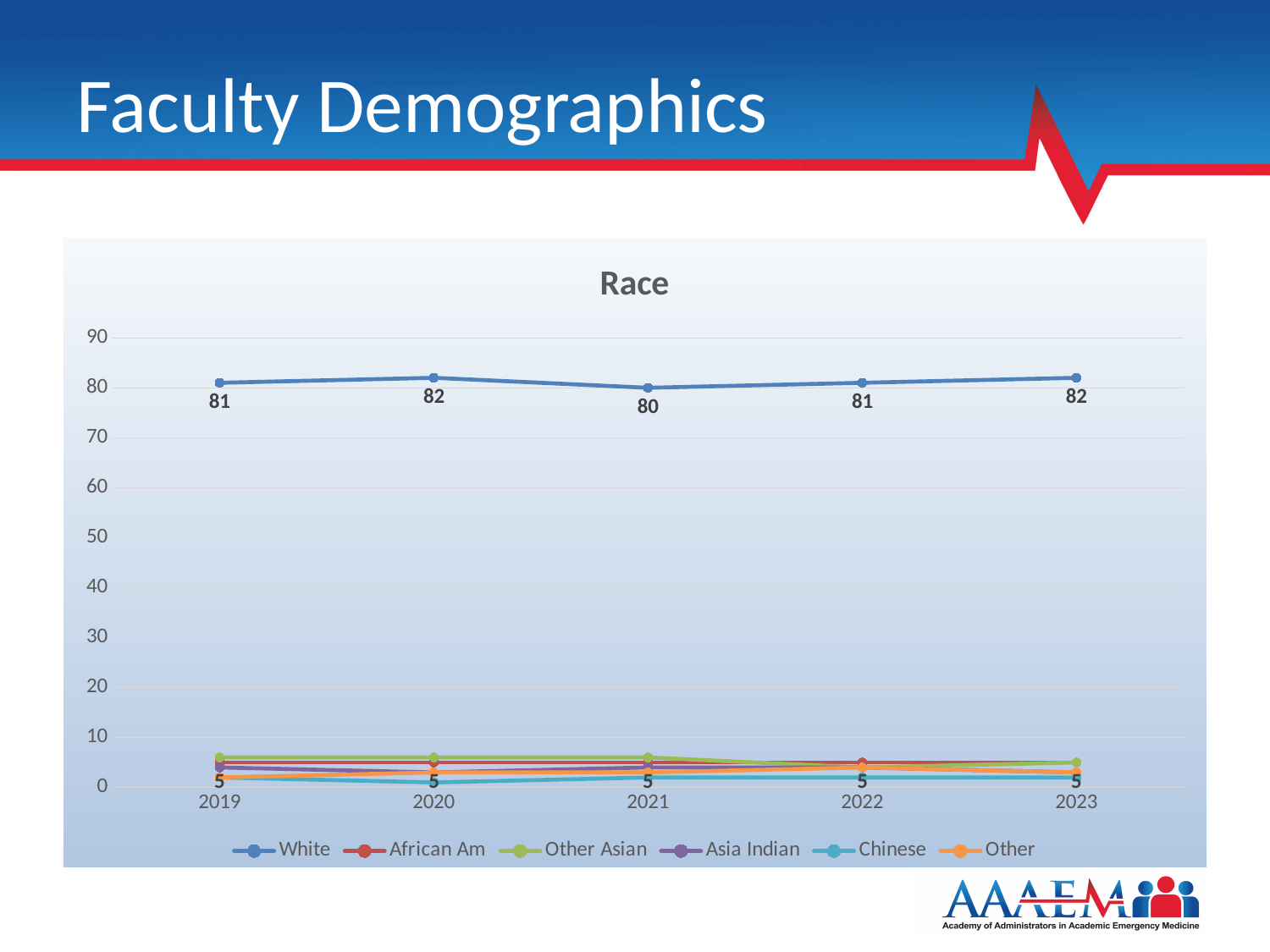
In which year is the value for White lowest? 2021 What is the difference between the White value in 2020 and in 2021? 2 What is the value for White in 2023? 82 Is the value for Chinese in 2020 greater or less than 10? less Is the value for White in 2022 greater or less than 70? greater How many series does the legend list? 6 What is the value for White in 2019? 81 What type of chart is shown on the slide? line chart What is the value for White in 2021? 80 How many years are shown on the x axis? 5 Which series has the highest values across all years? White What is the title of the chart? Race